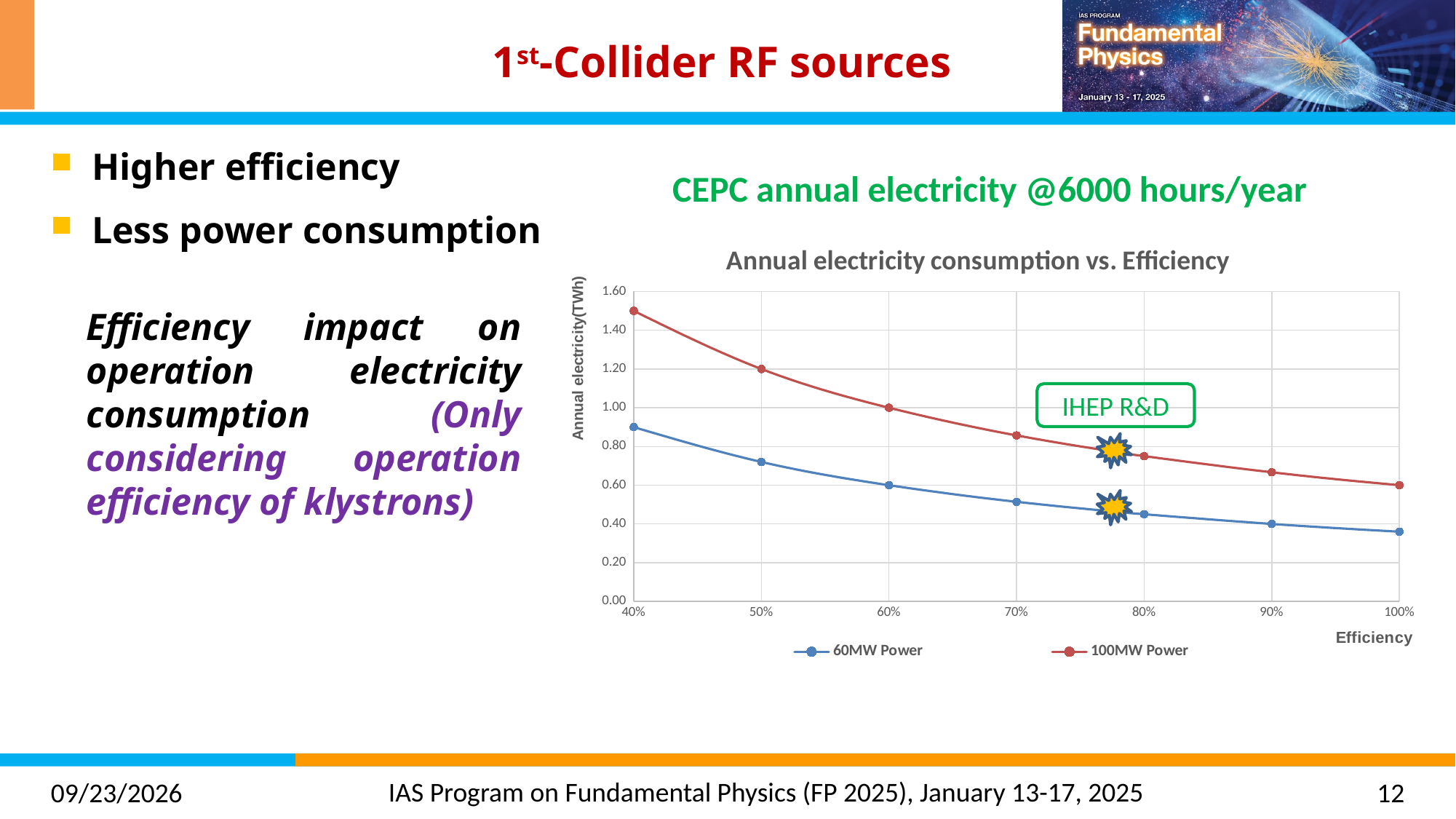
What is the annual electricity consumption for 100MW Power at 50% efficiency? 1.20 Is the value for 60MW Power at 100% efficiency greater or less than 0.40? less How many series does the chart legend list? 2 What is the annual electricity consumption for 100MW Power at 60% efficiency? 1.00 What kind of chart is shown on the slide? line chart What is the title of the chart? Annual electricity consumption vs. Efficiency At 70% efficiency, which series has the higher annual electricity consumption, 60MW Power or 100MW Power? 100MW Power What is the annual electricity consumption for 60MW Power at 60% efficiency? 0.60 Do the annual electricity values rise or fall as efficiency increases? fall What are the two series named in the chart legend? 60MW Power and 100MW Power Is the value for 60MW Power at 40% efficiency greater or less than 0.80? greater